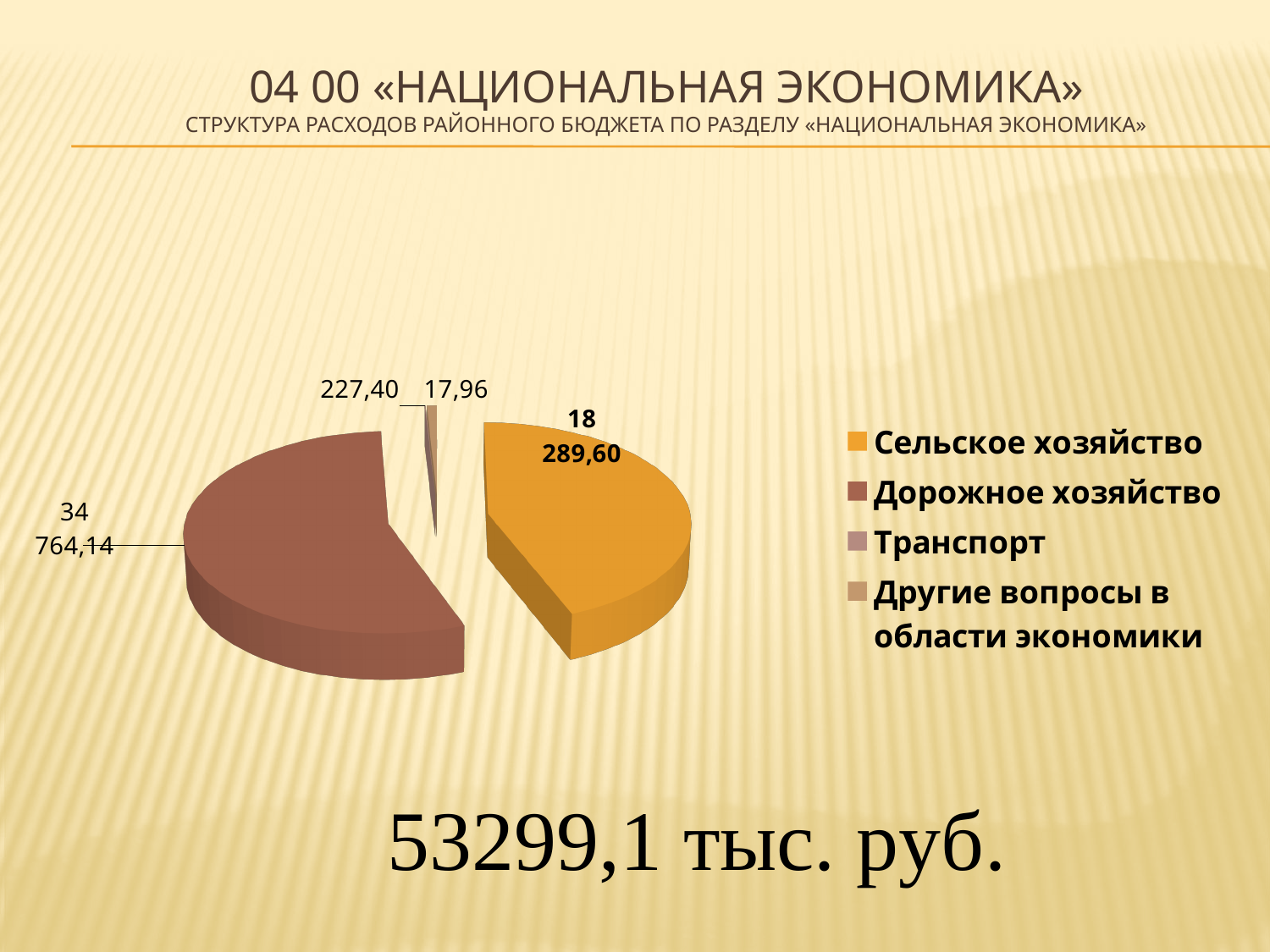
What is the difference between the values for Дорожное хозяйство and Сельское хозяйство? 16 474,54 Which category has the largest slice of the pie? Дорожное хозяйство What is the value shown for Дорожное хозяйство? 34 764,14 How many categories does the legend of the pie chart list? 4 What colour is the slice for Сельское хозяйство? orange What total amount is printed below the pie chart? 53299,1 тыс. руб. What is the value shown for Сельское хозяйство? 18 289,60 Which category is listed last in the legend? Другие вопросы в области экономики What kind of chart is shown on the slide? pie chart What is the smallest value printed on the pie chart? 17,96 Which is larger, Дорожное хозяйство or Сельское хозяйство? Дорожное хозяйство